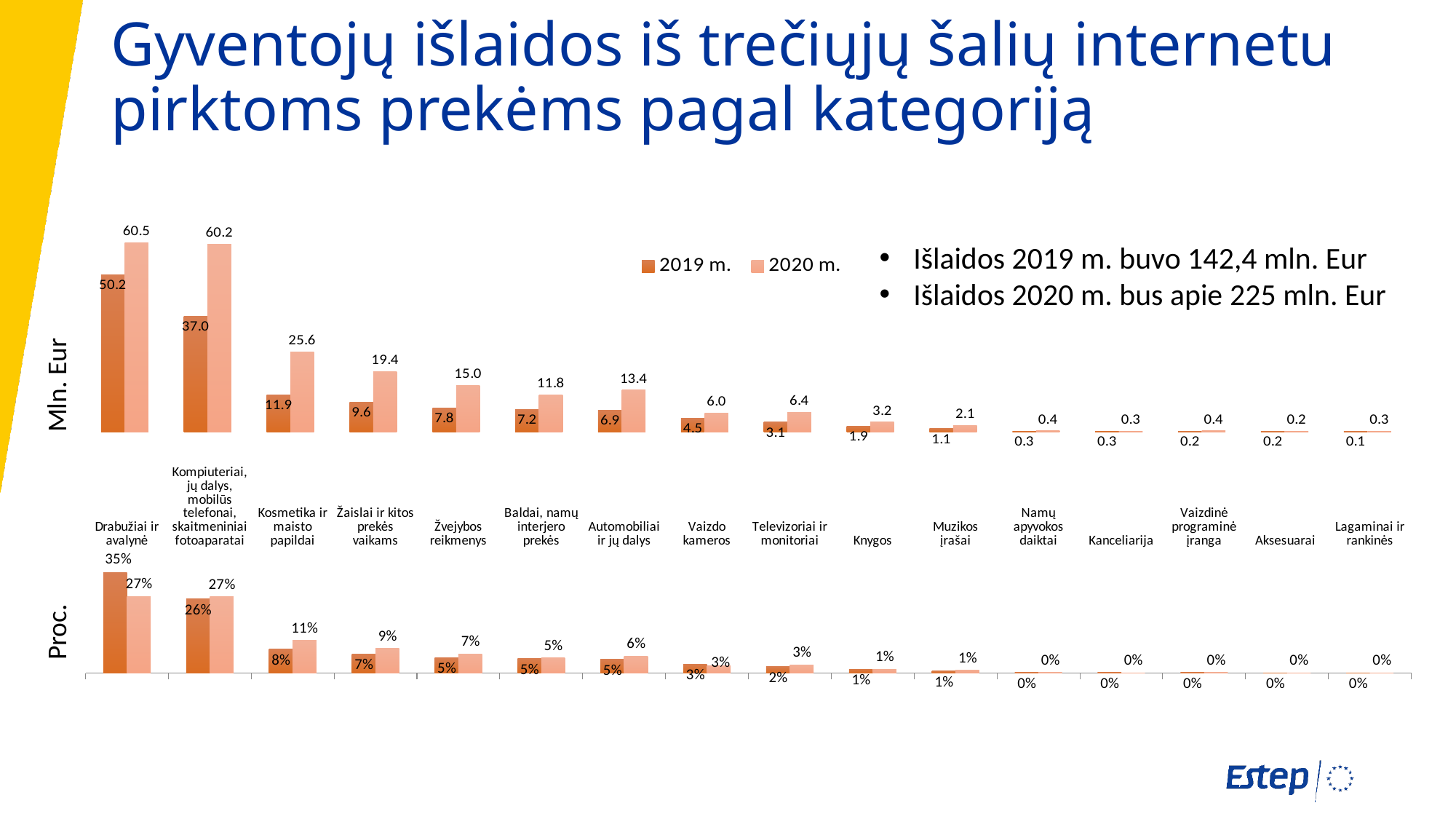
In the top chart (Mln. Eur), which category has the highest 2019 m. value? Drabužiai ir avalynė In the top chart (Mln. Eur), what is the 2020 m. value for Televizoriai ir monitoriai? 6.4 In the top chart (Mln. Eur), what is the difference between the 2020 m. and 2019 m. values for Kompiuteriai, jų dalys, mobilūs telefonai, skaitmeniniai fotoaparatai? 23.2 In the top chart (Mln. Eur), which category has the lowest 2019 m. value? Lagaminai ir rankinės In the bottom chart (Proc.), what is the 2019 m. share for Drabužiai ir avalynė? 35% In the bottom chart (Proc.), which is larger for Drabužiai ir avalynė: the 2019 m. share or the 2020 m. share? 2019 m. In the top chart (Mln. Eur), which is larger for Automobiliai ir jų dalys: the 2019 m. value or the 2020 m. value? 2020 m. What type of chart is the bottom chart (Proc.)? Bar chart In the top chart (Mln. Eur), what is the 2019 m. value for Kosmetika ir maisto papildai? 11.9 In the top chart (Mln. Eur), what is the 2020 m. value for Drabužiai ir avalynė? 60.5 How many categories are shown on the x axis of the top chart (Mln. Eur)? 16 How many series does the legend of the top chart list? 2